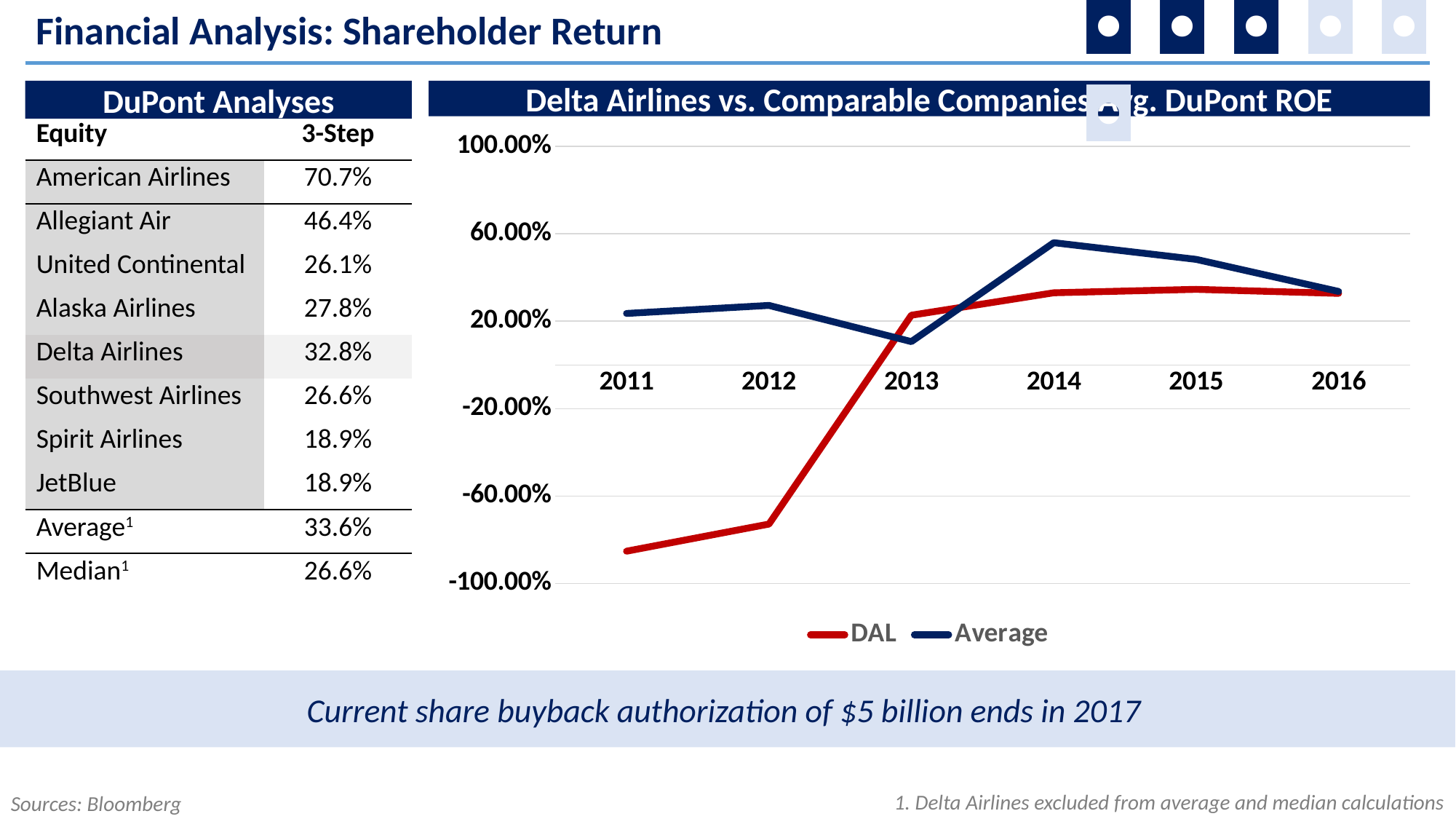
Is the DAL value for 2012 greater or less than -60.00%? less In which year is the Average line at its lowest value? 2013 Does the DAL line generally rise or fall from 2011 to 2016? rise Is the Average value for 2014 greater or less than 60.00%? less In 2014, which series has the larger value, DAL or Average? Average In which year is the DAL line at its lowest value? 2011 How many years are plotted along the x axis of the chart? 6 What colour is the DAL line in the chart? red How many series does the legend of the chart list? 2 In which year does the Average line reach its highest value? 2014 What kind of chart is shown on the slide? line chart In 2011, which series has the larger value, DAL or Average? Average